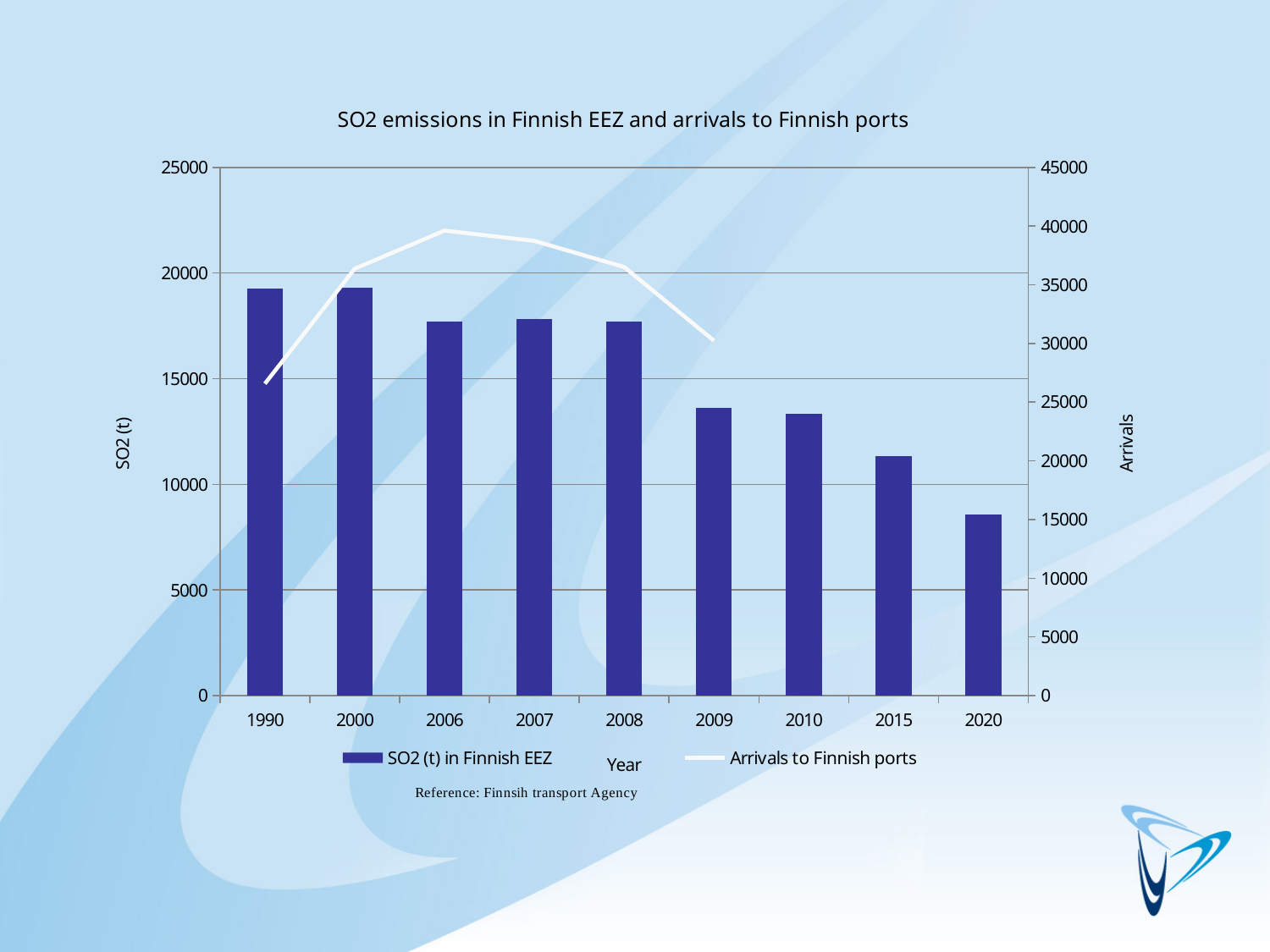
How many years are shown on the x axis of the chart? 9 What is the title of the chart? SO2 emissions in Finnish EEZ and arrivals to Finnish ports Is the SO2 (t) in Finnish EEZ value for 1990 greater or less than 15000? greater Is the Arrivals to Finnish ports value for 2006 greater or less than 35000 on the right axis? greater Do the SO2 (t) in Finnish EEZ bars generally rise or fall from 2008 to 2020? fall What kind of chart is shown on the slide? A combined bar and line chart Which year has the larger SO2 (t) in Finnish EEZ bar, 2008 or 2009? 2008 Which year has the lowest SO2 (t) in Finnish EEZ bar? 2020 Is the SO2 (t) in Finnish EEZ value for 2009 greater or less than 15000? less In which year does the Arrivals to Finnish ports line reach its highest point? 2006 How many series does the chart legend list? 2